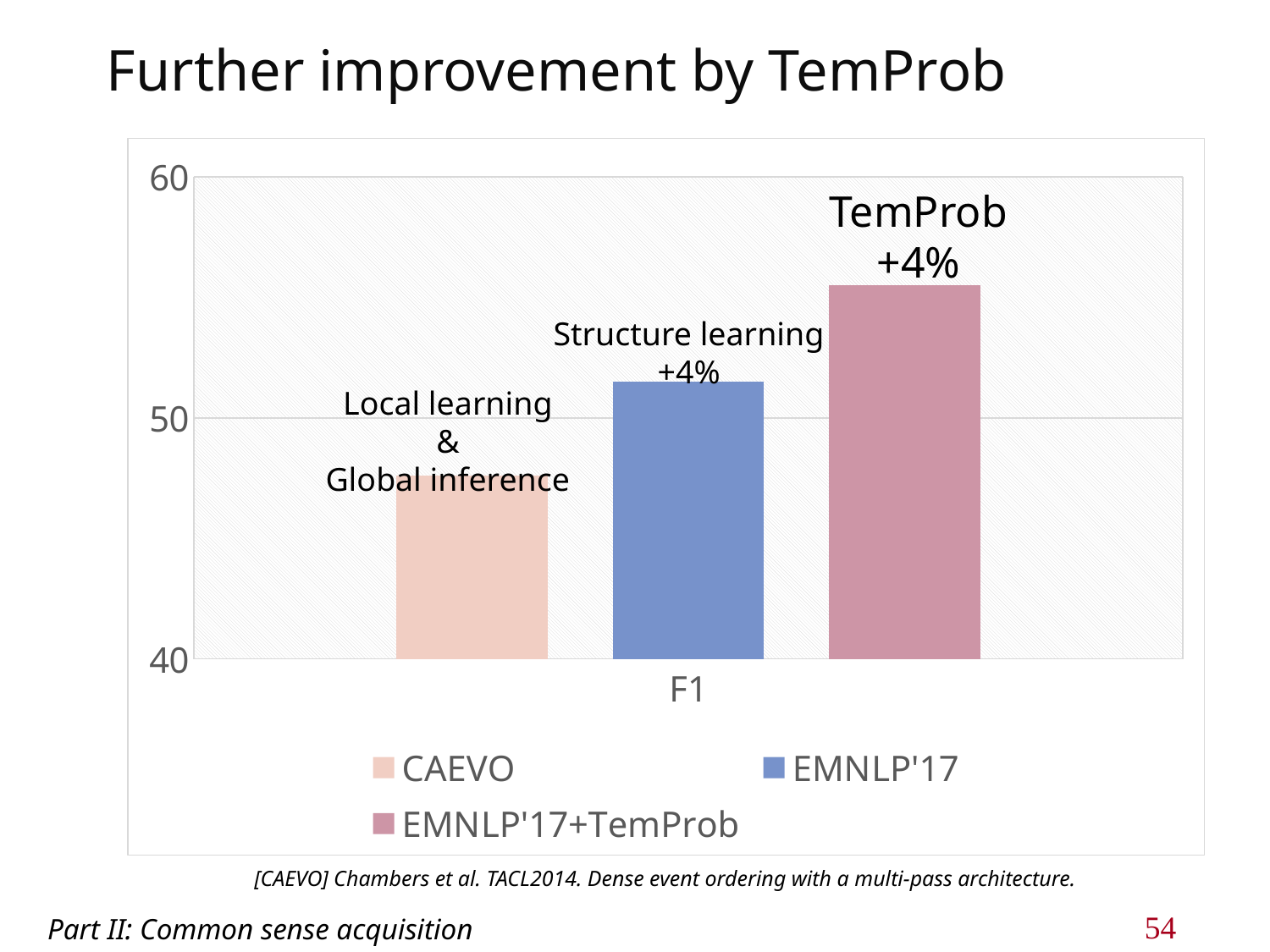
How many categories are shown on the x axis? 1 What is the category label on the x axis? F1 Is the F1 value for EMNLP'17 greater or less than 50? greater How many series does the legend list? 3 Is the F1 value for CAEVO greater or less than 50? less What improvement is annotated above the TemProb bar? +4% Which is larger, the F1 bar for EMNLP'17 or the F1 bar for CAEVO? EMNLP'17 Which series has the highest F1 bar? EMNLP'17+TemProb What kind of chart is shown on the slide? bar chart Which series has the lowest F1 bar? CAEVO Which is larger, the F1 bar for EMNLP'17+TemProb or the F1 bar for EMNLP'17? EMNLP'17+TemProb Is the F1 value for EMNLP'17+TemProb greater or less than 60? less